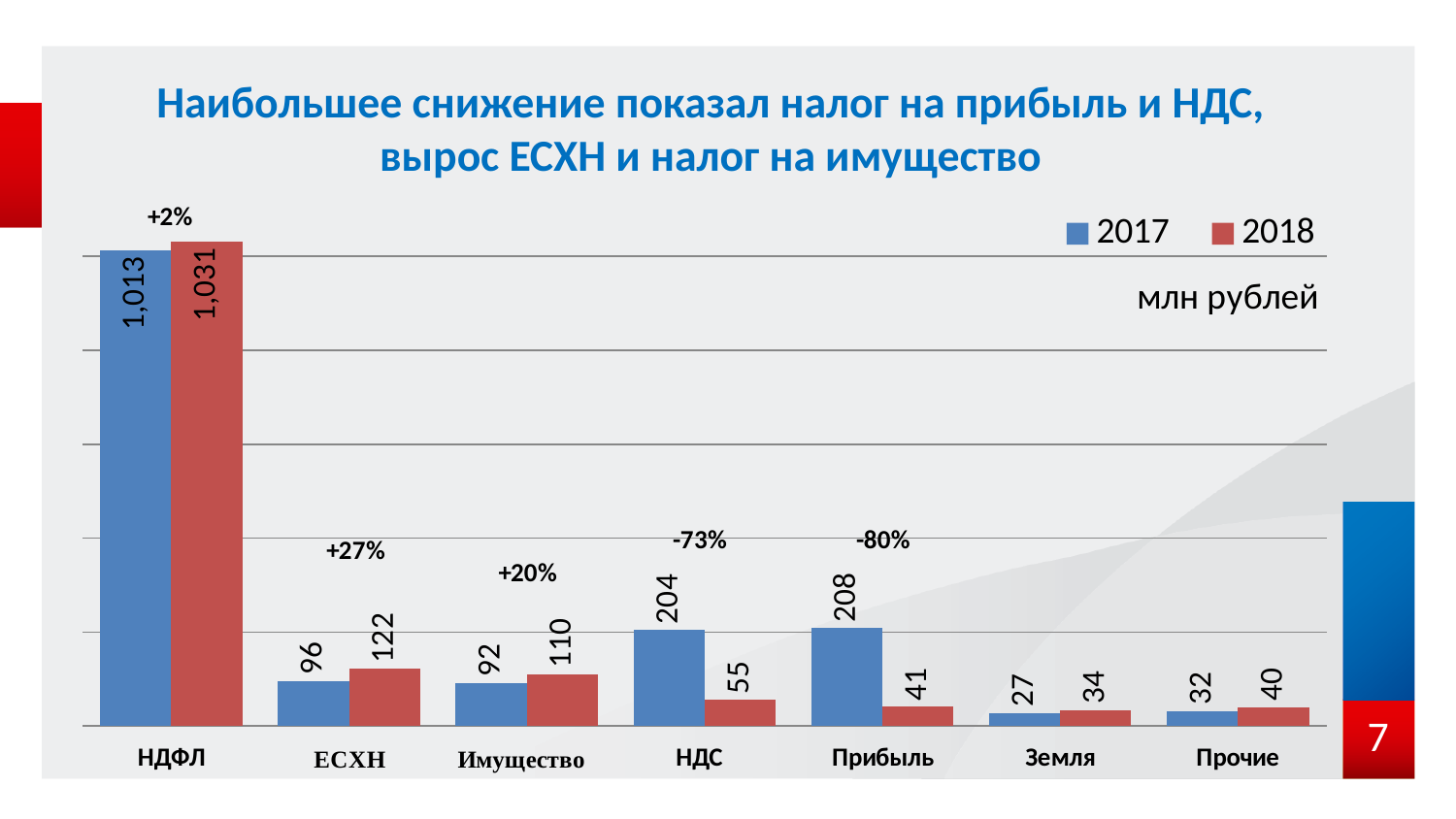
What is the value for НДФЛ in 2017? 1,013 Which category has the lowest value in 2017? Земля How many categories are shown on the x axis? 7 What is the difference between the 2017 and 2018 values for Прибыль? 167 Which is larger for Имущество: the 2017 value or the 2018 value? 2018 What is the value for Прибыль in 2017? 208 What is the value for Земля in 2018? 34 What is the value for НДС in 2018? 55 How many series does the legend list? 2 What kind of chart is shown on the slide? Bar chart What is the difference between the 2018 and 2017 values for ЕСХН? 26 Which category has the highest value in 2018? НДФЛ